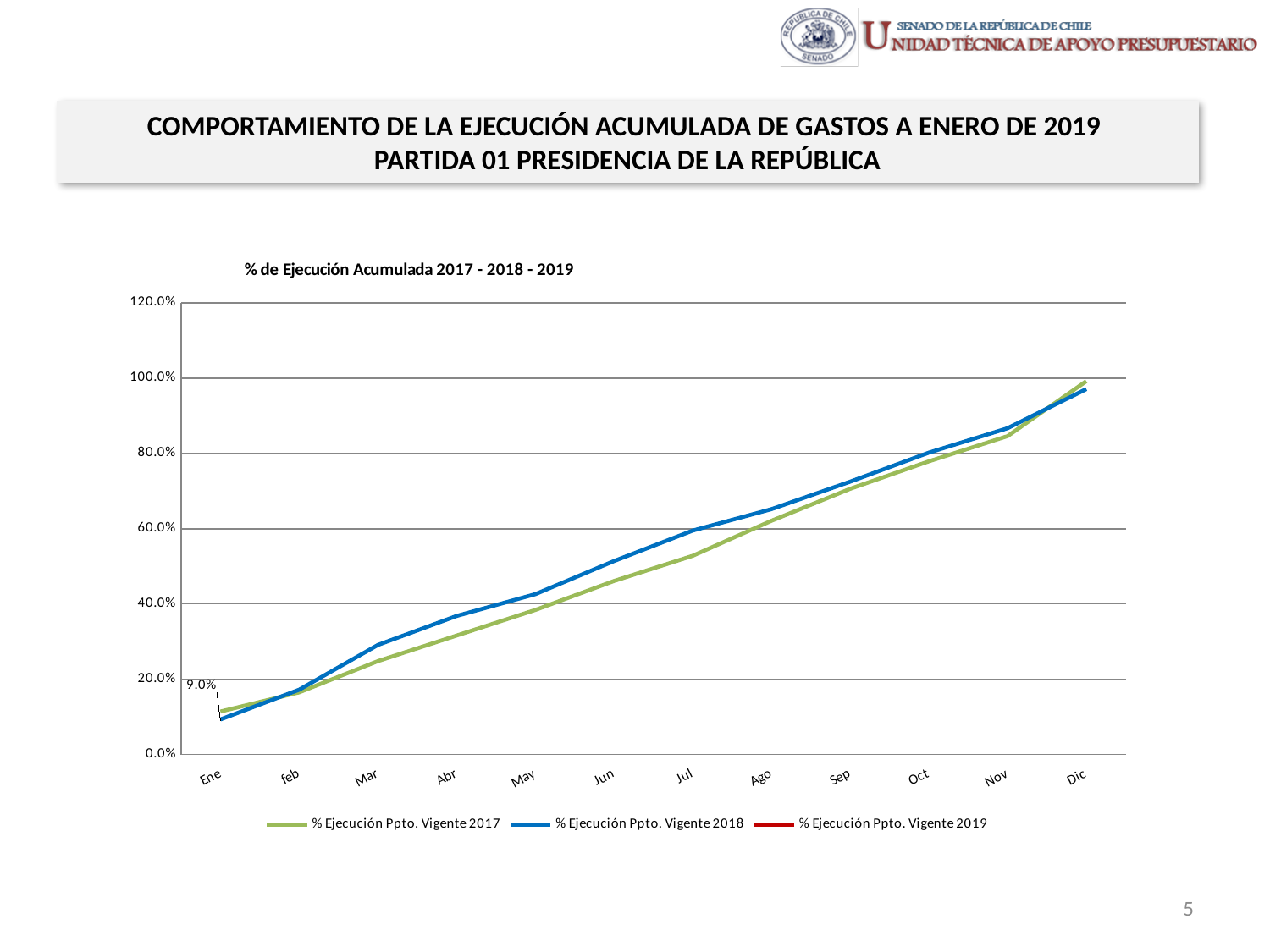
In which month does % Ejecución Ppto. Vigente 2018 reach its highest value? Dic Is the value for % Ejecución Ppto. Vigente 2017 in Jul greater or less than 60.0%? less In Jul, which series has the higher value, % Ejecución Ppto. Vigente 2017 or % Ejecución Ppto. Vigente 2018? % Ejecución Ppto. Vigente 2018 How many series does the legend list? 3 Is the value for % Ejecución Ppto. Vigente 2018 in Mar greater or less than 20.0%? greater What is the title of the chart? % de Ejecución Acumulada 2017 - 2018 - 2019 In which month is % Ejecución Ppto. Vigente 2017 at its lowest value? Ene Is the value for % Ejecución Ppto. Vigente 2018 in Dic greater or less than 80.0%? greater How many months are shown along the x axis? 12 Do the values for % Ejecución Ppto. Vigente 2018 rise or fall from Ene to Dic? rise What kind of chart is shown on the slide? line chart What is the only data label printed on the chart? 9.0%